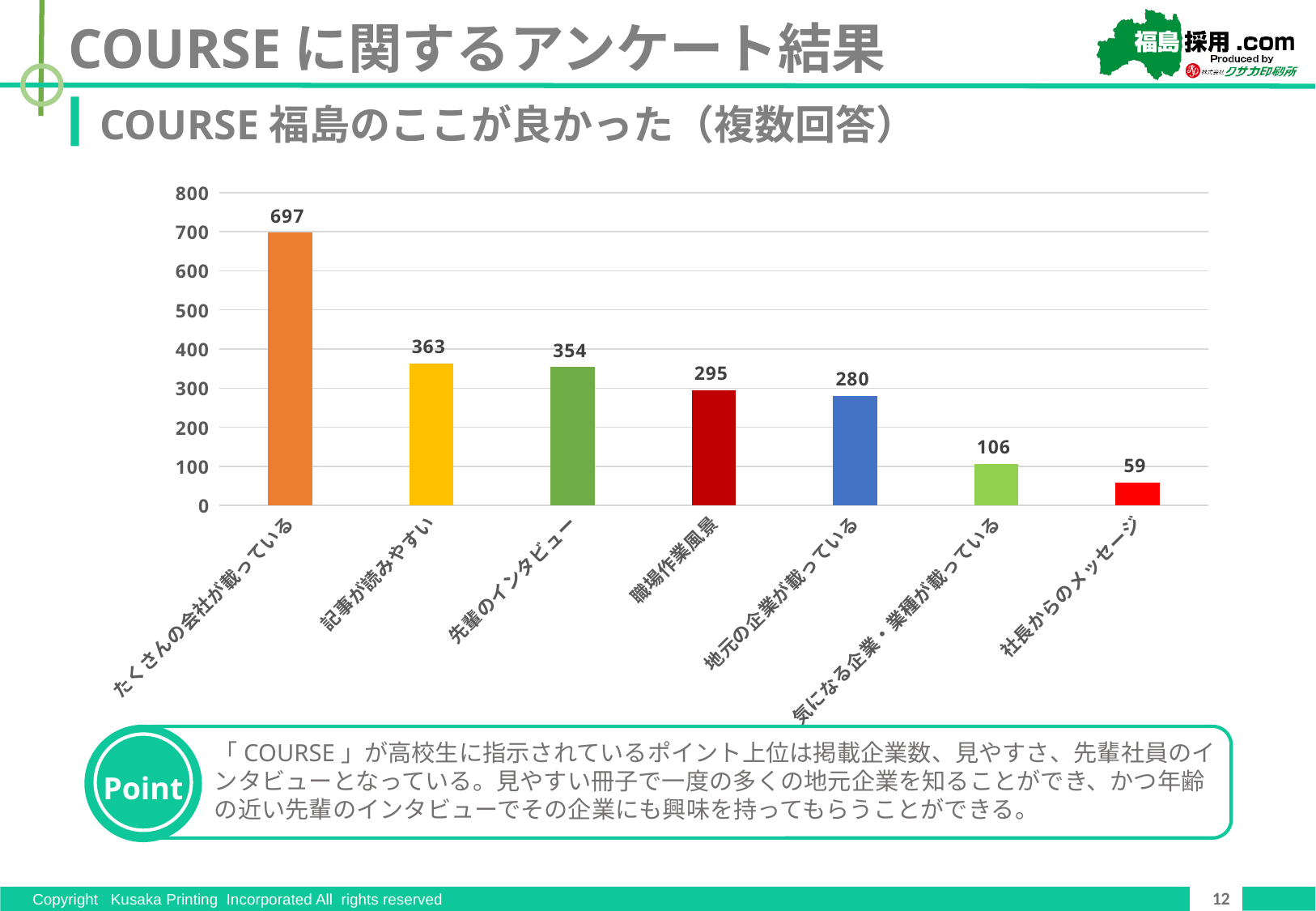
How many categories are shown in the chart? 7 Is the value for 地元の企業が載っている greater or less than 300? less Which is larger, the value for 気になる企業・業種が載っている or the value for 社長からのメッセージ? 気になる企業・業種が載っている What is the difference between the values for 記事が読みやすい and 先輩のインタビュー? 9 What is the value for 社長からのメッセージ? 59 What kind of chart is shown on the slide? bar chart What is the value for たくさんの会社が載っている? 697 What is the value for 先輩のインタビュー? 354 What is the difference between the values for 職場作業風景 and 地元の企業が載っている? 15 Which category has the highest value? たくさんの会社が載っている Which category has the lowest value? 社長からのメッセージ Do the values rise or fall from left to right along the x axis? fall